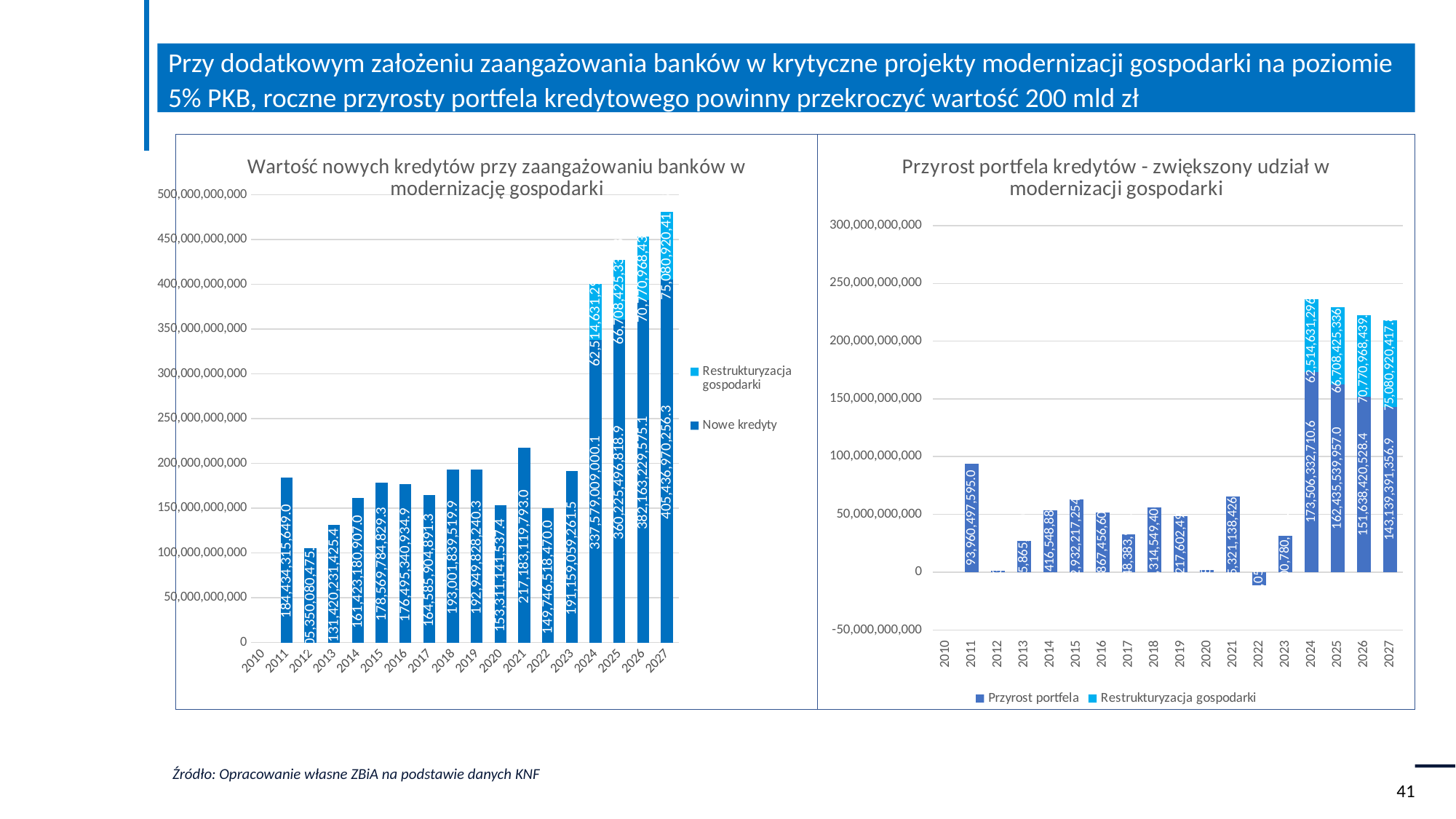
In the right chart, 'Przyrost portfela kredytów - zwiększony udział w modernizacji gospodarki', what is the 'Przyrost portfela' value for 2011? 93,960,497,595.0 In the right chart, what is the difference between the 'Przyrost portfela' values for 2024 and 2025? 11,070,792,753.6 In the left chart, is the 'Nowe kredyty' value for 2021 or for 2023 larger? 2021 In the right chart, do the 'Przyrost portfela' values rise or fall from 2024 to 2027? fall In the left chart, which year has the lowest value of 'Nowe kredyty'? 2012 In the right chart, what is the 'Restrukturyzacja gospodarki' value for 2027? 75,080,920,417.8 In the left chart, is the value for 2011 greater or less than 200,000,000,000? less In the left chart, which year has the highest value of 'Nowe kredyty'? 2027 How many series does the legend of the left chart list? 2 What kind of chart is the left chart, 'Wartość nowych kredytów przy zaangażowaniu banków w modernizację gospodarki'? bar chart In the left chart, what is the value of 'Nowe kredyty' for 2021? 217,183,119,793.0 In the left chart, what is the value of 'Nowe kredyty' for 2015? 178,569,784,829.3